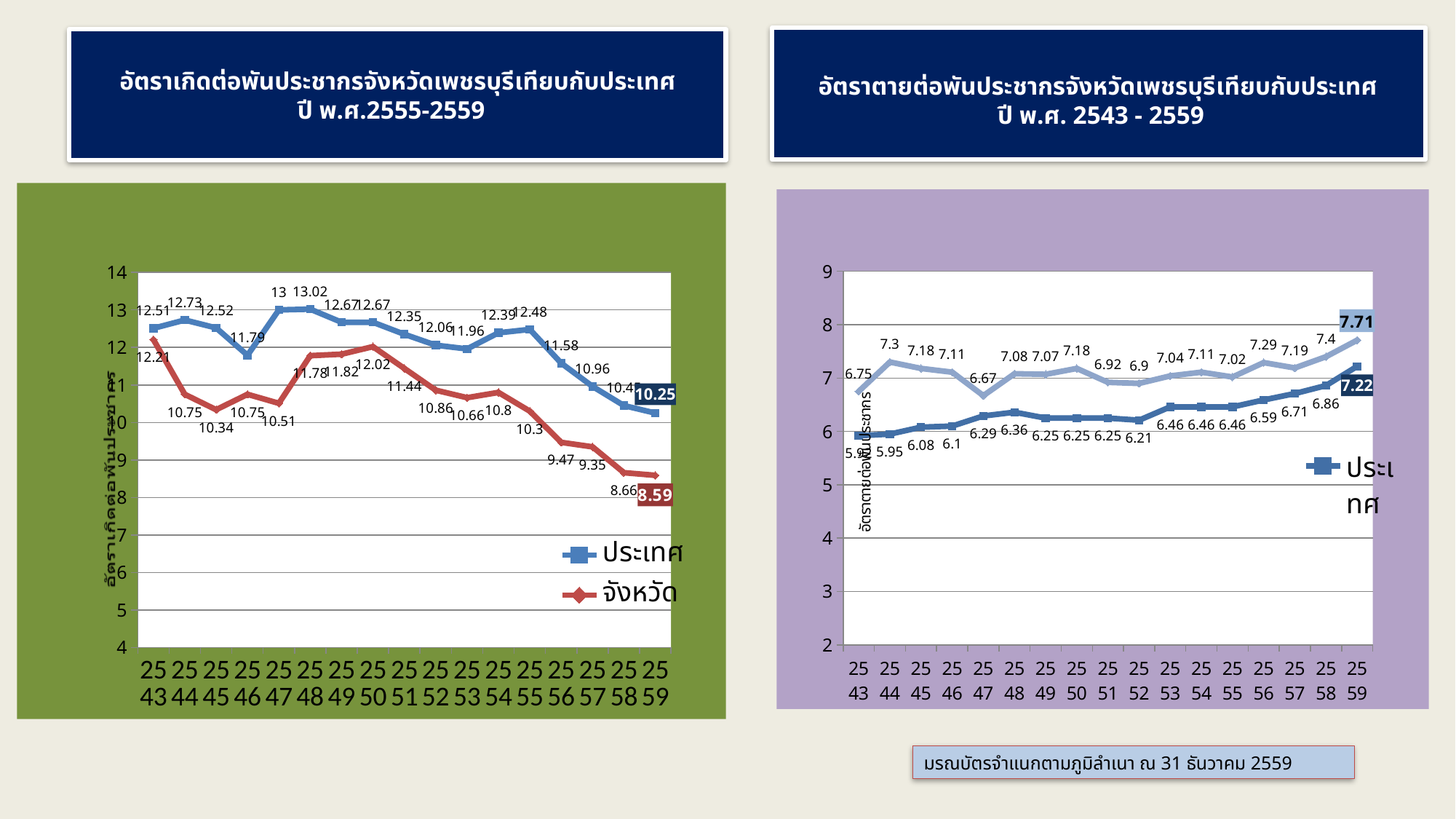
What kind of chart is the left chart (อัตราเกิดต่อพันประชากร)? line chart In the left chart (อัตราเกิดต่อพันประชากร), what is the value for ประเทศ in 2559? 10.25 In the left chart (อัตราเกิดต่อพันประชากร), what is the difference between ประเทศ and จังหวัด in 2559? 1.66 In the right chart (อัตราตายต่อพันประชากร), what is the value of the lower line in 2559? 7.22 In the right chart (อัตราตายต่อพันประชากร), what is the difference between the two lines in 2559? 0.49 In the left chart (อัตราเกิดต่อพันประชากร), in which year does the ประเทศ series reach its highest value? 2548 In the left chart (อัตราเกิดต่อพันประชากร), what is the value for จังหวัด in 2559? 8.59 In the left chart (อัตราเกิดต่อพันประชากร), does the จังหวัด series rise or fall from 2555 to 2559? fall How many series does the legend of the left chart (อัตราเกิดต่อพันประชากร) list? 2 How many years are shown on the x axis of the left chart (อัตราเกิดต่อพันประชากร)? 17 In the right chart (อัตราตายต่อพันประชากร), what is the highest value of the upper line? 7.71 In the left chart (อัตราเกิดต่อพันประชากร), what is the lowest value of the จังหวัด series? 8.59